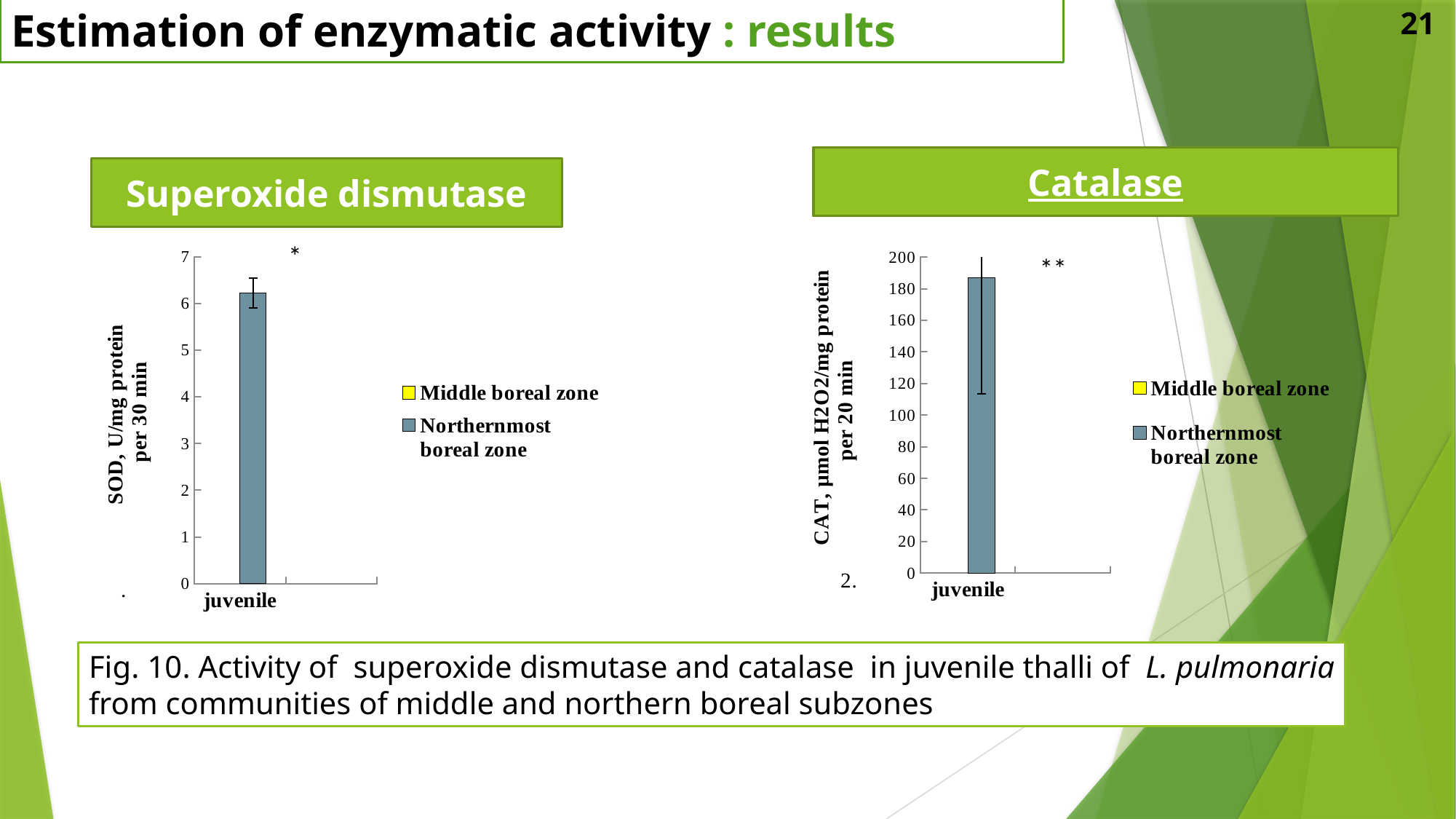
What kind of chart is the Superoxide dismutase chart? bar chart What is the category label on the x axis of the Catalase chart? juvenile In the Superoxide dismutase chart, is the value for Northernmost boreal zone greater or less than 7? less How many series does the legend of the Superoxide dismutase chart list? 2 How many categories are shown on the x axis of the Superoxide dismutase chart? 1 What is the y-axis title of the Catalase chart? CAT, µmol H2O2/mg protein per 20 min In the Superoxide dismutase chart, which legend series is shown in yellow? Middle boreal zone In the Superoxide dismutase chart, is the value for Northernmost boreal zone greater or less than 5? greater What kind of chart is the Catalase chart? bar chart In the Catalase chart, is the value for Northernmost boreal zone greater or less than 200? less How many series does the legend of the Catalase chart list? 2